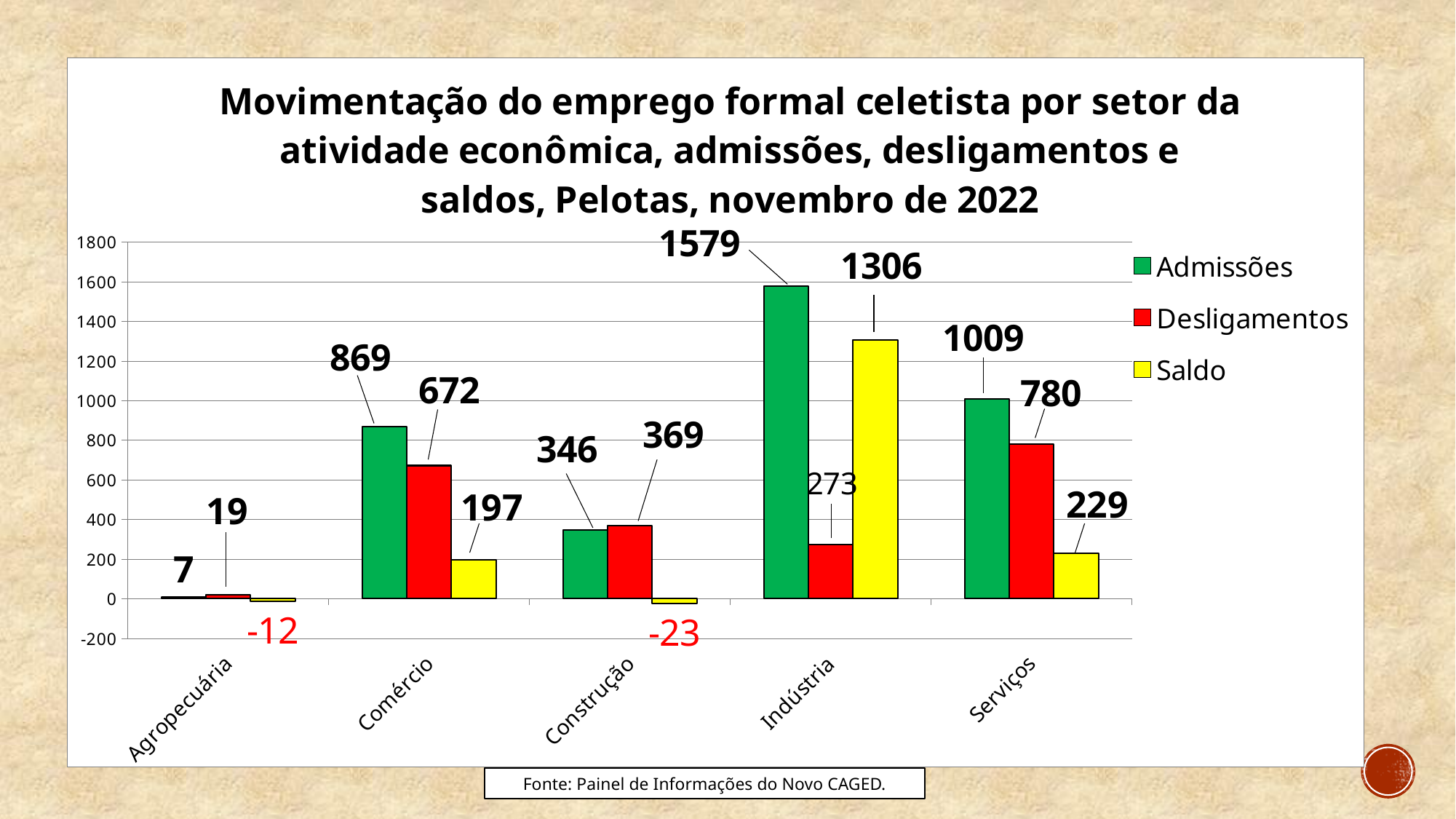
Which colour represents the Saldo series in the legend? Yellow How many series does the legend list? 3 What is the Saldo value for Construção? -23 What is the difference between Admissões and Desligamentos for Comércio? 197 What is the Desligamentos value for Serviços? 780 Which is larger for Construção, Admissões or Desligamentos? Desligamentos Which sector has the lowest Desligamentos value? Agropecuária What kind of chart is shown on the slide? Bar chart What is the Saldo value for Agropecuária? -12 What is the Admissões value for Indústria? 1579 Which sector has the highest Admissões value? Indústria How many sectors are shown on the x axis? 5